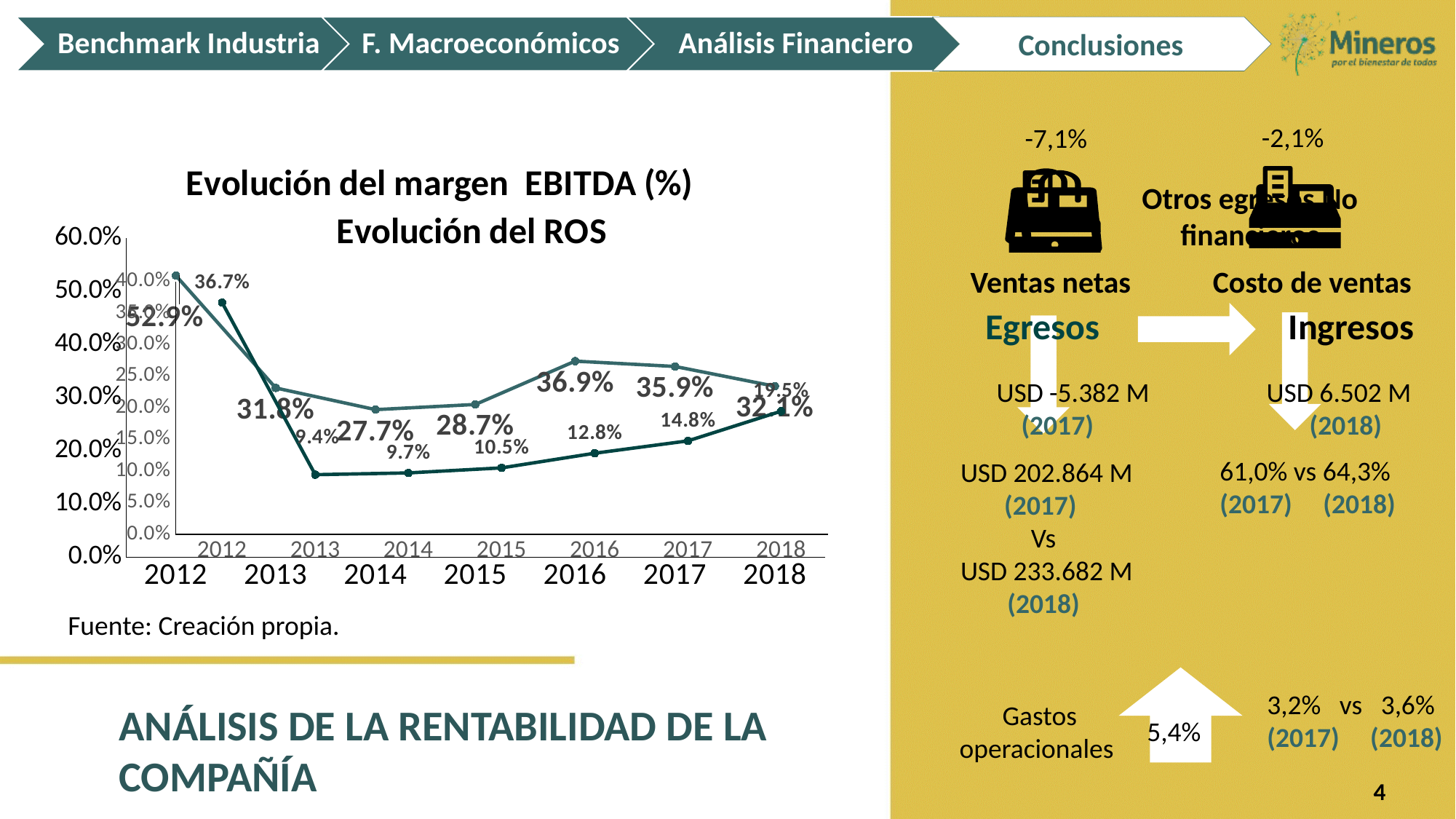
In the 'Evolución del ROS' chart, which year has the lowest ROS value? 2013 How many years are plotted in the 'Evolución del ROS' chart? 7 In the 'Evolución del ROS' chart, what is the ROS value for 2013? 9.4% In the 'Evolución del margen EBITDA (%)' chart, what is the EBITDA margin for 2016? 36.9% In the 'Evolución del ROS' chart, what is the difference between the ROS value in 2018 and in 2017? 4.7% In the 'Evolución del margen EBITDA (%)' chart, what is the EBITDA margin for 2012? 52.9% In the 'Evolución del margen EBITDA (%)' chart, which year has the lowest EBITDA margin? 2014 In the 'Evolución del margen EBITDA (%)' chart, is the EBITDA margin higher in 2016 or in 2017? 2016 In the 'Evolución del margen EBITDA (%)' chart, what is the difference between the EBITDA margin in 2012 and in 2013? 21.1% In the 'Evolución del margen EBITDA (%)' chart, which year has the highest EBITDA margin? 2012 What type of chart is 'Evolución del margen EBITDA (%)'? Line chart In the 'Evolución del ROS' chart, what is the ROS value for 2018? 19.5%